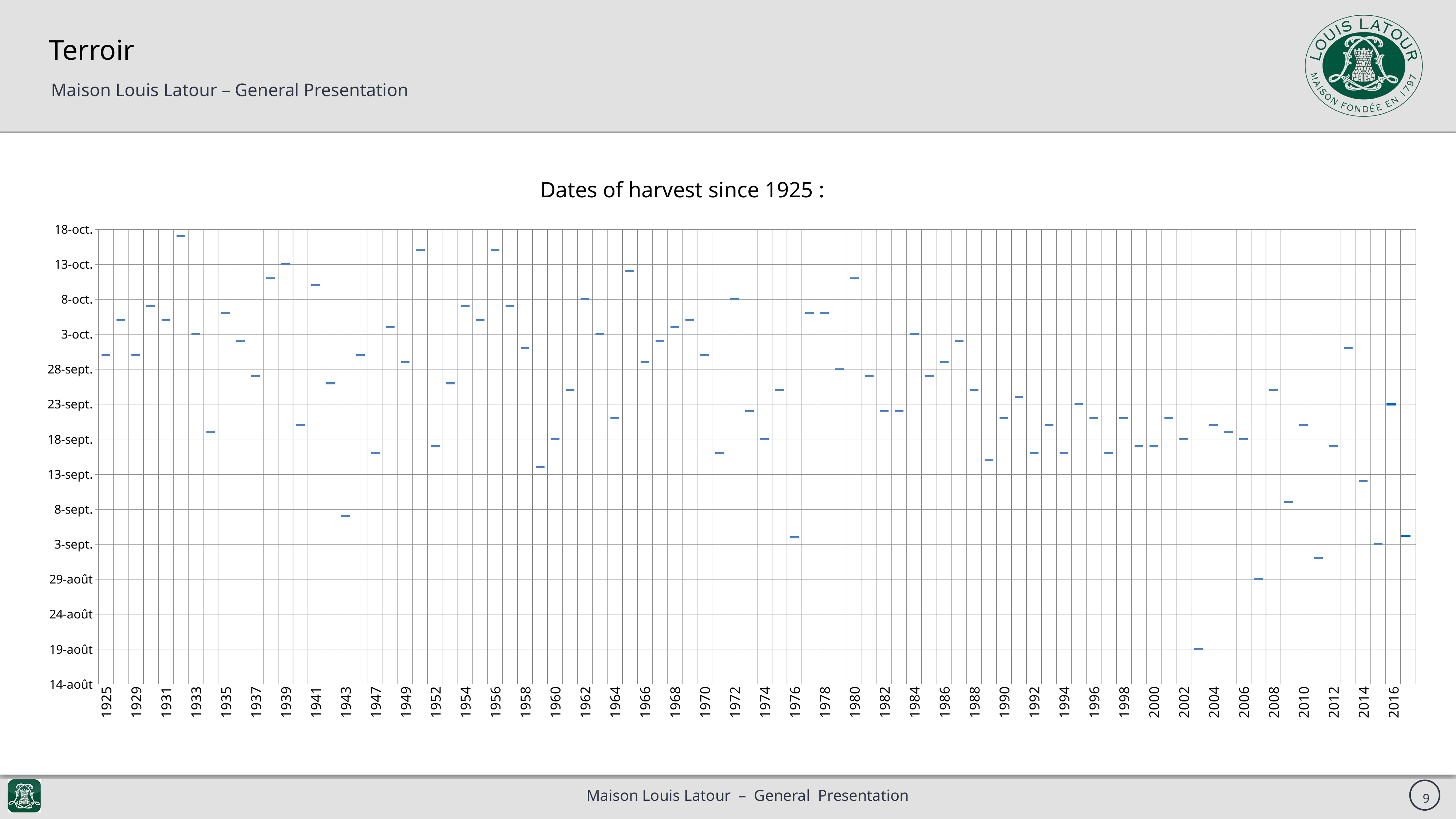
What is the harvest date plotted for 1939? 13-oct. Is the harvest date for 1956 before or after 13-oct.? after Overall, do the harvest dates become earlier or later from 1925 to 2016? earlier Which year has the earlier harvest date, 1976 or 1980? 1976 What is the harvest date plotted for 2016? 23-sept. What is the harvest date plotted for 1984? 3-oct. What is the harvest date plotted for 1962? 8-oct. What is the harvest date plotted for 1974? 18-sept. Which year has the later harvest date, 1939 or 1943? 1939 What is the title of the chart? Dates of harvest since 1925 : Is the harvest date for 1943 before or after 8-sept.? before